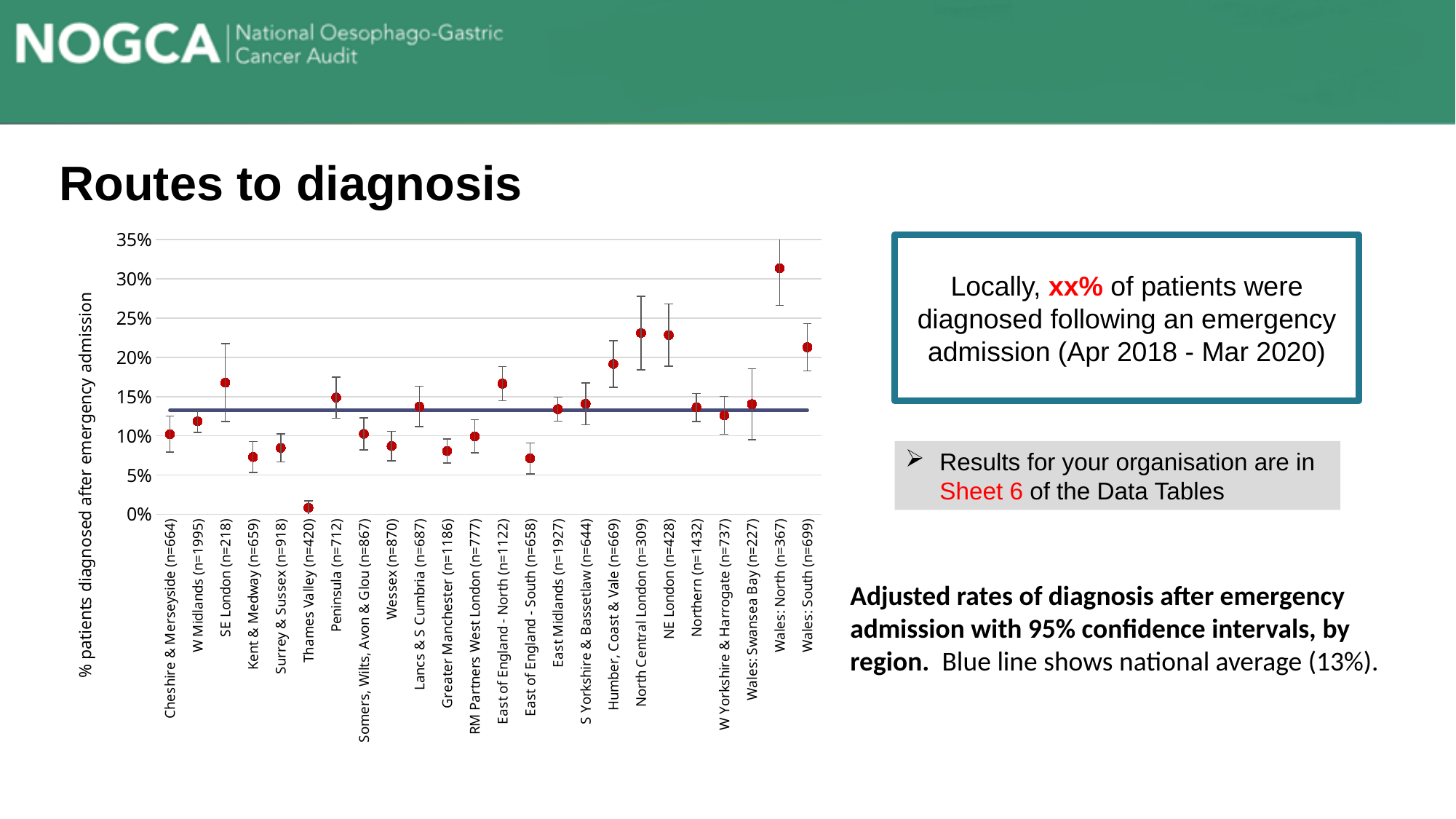
Which has the higher rate: NE London or Cheshire & Merseyside? NE London Which region has the lowest rate of diagnosis after emergency admission? Thames Valley (n=420) What is the label on the y axis of the chart? % patients diagnosed after emergency admission How many regions are plotted along the x axis? 24 Is the value for Wales: North greater or less than 25%? greater Which region has the highest rate of diagnosis after emergency admission? Wales: North (n=367) What kind of chart is shown on the slide? scatter chart with error bars Is the value for Thames Valley greater or less than 5%? less Is the value for Kent & Medway greater or less than 10%? less Which has the higher rate: Wales: North or Wales: South? Wales: North What national average does the blue line on the chart represent? 13%